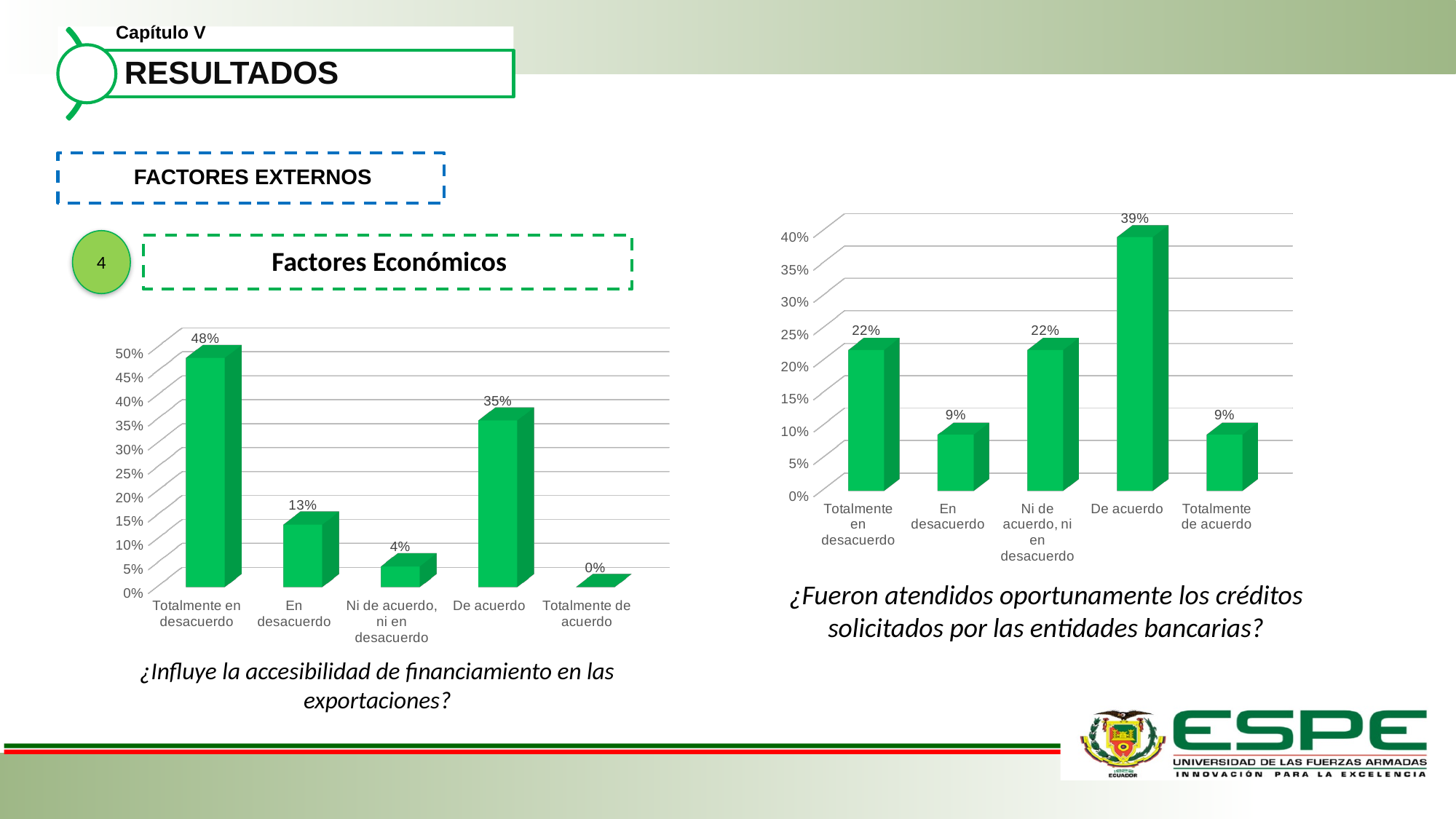
In the left chart (¿Influye la accesibilidad de financiamiento en las exportaciones?), what is the difference between 'Totalmente en desacuerdo' and 'De acuerdo'? 13% In the left chart (¿Influye la accesibilidad de financiamiento en las exportaciones?), how many categories are shown? 5 In the right chart (¿Fueron atendidos oportunamente los créditos solicitados por las entidades bancarias?), which category has the highest value? De acuerdo What type of chart is the right chart (¿Fueron atendidos oportunamente los créditos solicitados por las entidades bancarias?)? Bar chart In the right chart (¿Fueron atendidos oportunamente los créditos solicitados por las entidades bancarias?), what is the difference between 'De acuerdo' and 'Totalmente en desacuerdo'? 17% In the left chart (¿Influye la accesibilidad de financiamiento en las exportaciones?), what is the value for 'Totalmente en desacuerdo'? 48% In the right chart (¿Fueron atendidos oportunamente los créditos solicitados por las entidades bancarias?), what is the value for 'De acuerdo'? 39% In the right chart (¿Fueron atendidos oportunamente los créditos solicitados por las entidades bancarias?), is the value for 'Totalmente de acuerdo' greater or less than 10%? less In the left chart (¿Influye la accesibilidad de financiamiento en las exportaciones?), which is larger: 'En desacuerdo' or 'Ni de acuerdo, ni en desacuerdo'? En desacuerdo In the left chart (¿Influye la accesibilidad de financiamiento en las exportaciones?), what is the value for 'De acuerdo'? 35% In the right chart (¿Fueron atendidos oportunamente los créditos solicitados por las entidades bancarias?), what is the value for 'En desacuerdo'? 9% In the left chart (¿Influye la accesibilidad de financiamiento en las exportaciones?), which category has the lowest value? Totalmente de acuerdo